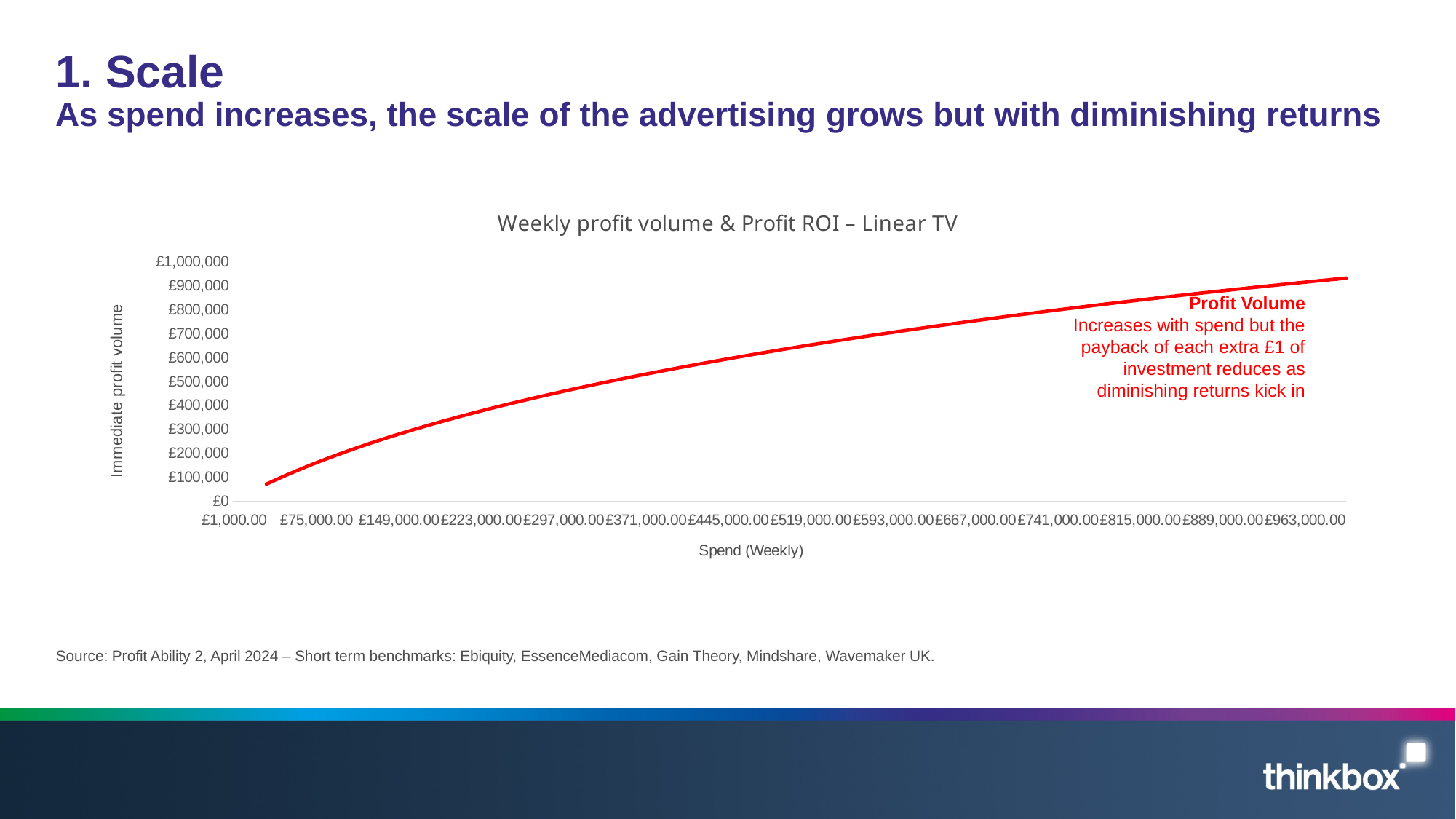
Does the profit volume line rise or fall as weekly spend increases along the x axis? Rises Which weekly spend value shown on the x axis has the highest profit volume? £963,000.00 Is the profit volume at a weekly spend of £963,000.00 greater or less than £800,000? greater What is the title of the chart? Weekly profit volume & Profit ROI – Linear TV What kind of chart is shown on the slide? Line chart Is the profit volume at a weekly spend of £519,000.00 greater or less than £500,000? greater Is the profit volume at a weekly spend of £297,000.00 greater or less than £600,000? less What is the label of the vertical axis? Immediate profit volume How many spend values are labelled on the x axis of the chart? 14